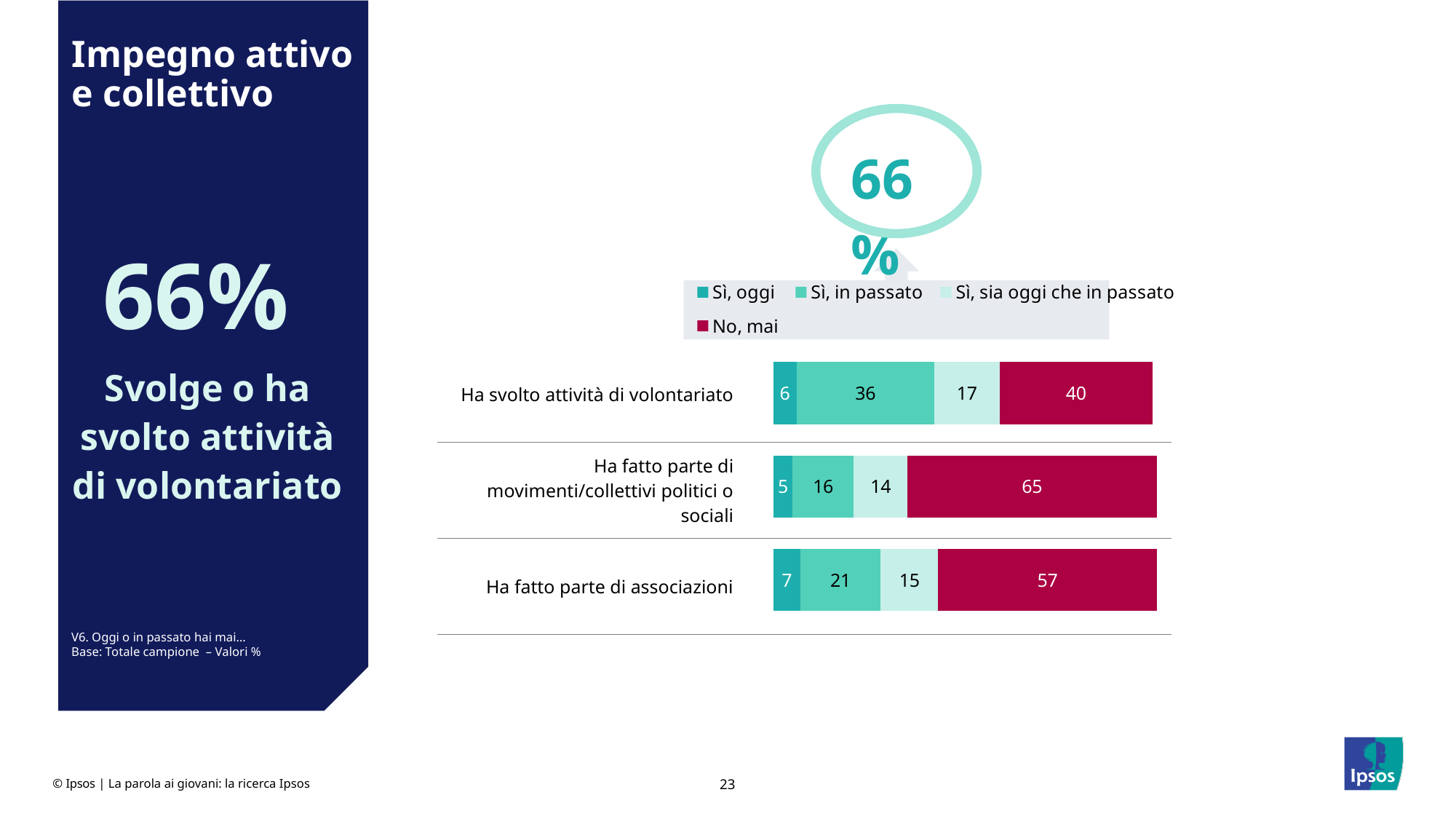
What is the value for "No, mai" in the "Ha svolto attività di volontariato" bar? 40 Which category has the highest value for "No, mai"? Ha fatto parte di movimenti/collettivi politici o sociali What kind of chart is shown on the slide? Stacked bar chart What is the value for "Sì, sia oggi che in passato" in the "Ha svolto attività di volontariato" bar? 17 How many series does the legend list? 4 What is the difference between the "No, mai" values for "Ha fatto parte di movimenti/collettivi politici o sociali" and "Ha svolto attività di volontariato"? 25 What is the value for "Sì, oggi" in the "Ha fatto parte di movimenti/collettivi politici o sociali" bar? 5 Which category has the lowest value for "Sì, in passato"? Ha fatto parte di movimenti/collettivi politici o sociali How many categories are shown in the bar chart? 3 What is the total of the "Ha fatto parte di associazioni" bar? 100 What is the value for "Sì, in passato" in the "Ha fatto parte di associazioni" bar? 21 Which is larger: the "Sì, in passato" value for "Ha svolto attività di volontariato" or for "Ha fatto parte di associazioni"? Ha svolto attività di volontariato